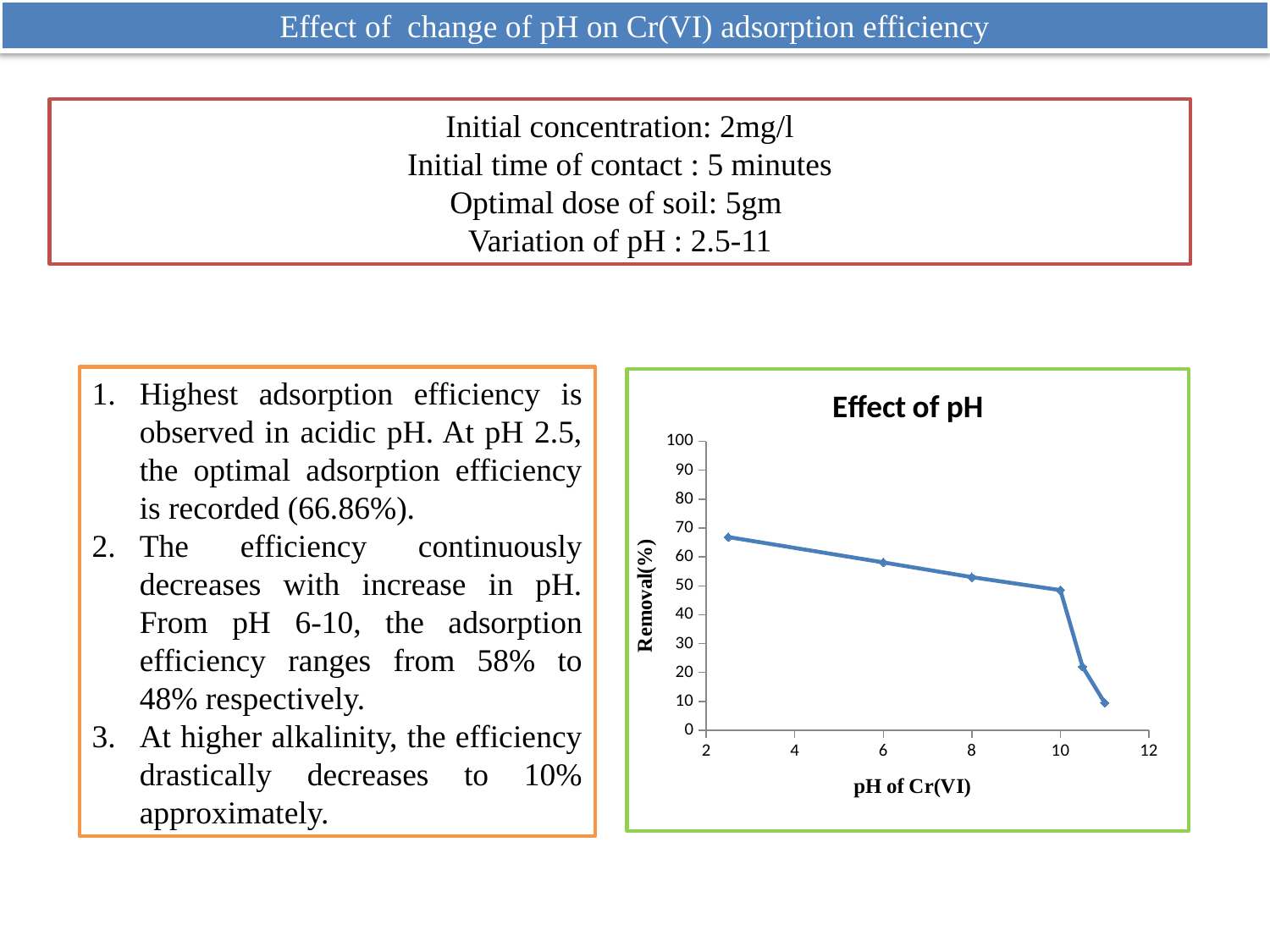
Does the removal percentage rise or fall as pH increases along the x axis? fall Which has a higher removal percentage, pH 6 or pH 10? pH 6 What kind of chart is shown on the slide? line chart Is the removal value at pH 6 greater or less than 50? greater At which pH value is the removal percentage highest? 2.5 What is the title of the chart? Effect of pH How many data points are plotted on the chart? 6 Is the removal value at pH 11 greater or less than 20? less What is the label of the vertical axis of the chart? Removal(%) Is the removal value at pH 8 greater or less than 60? less At which pH value is the removal percentage lowest? 11